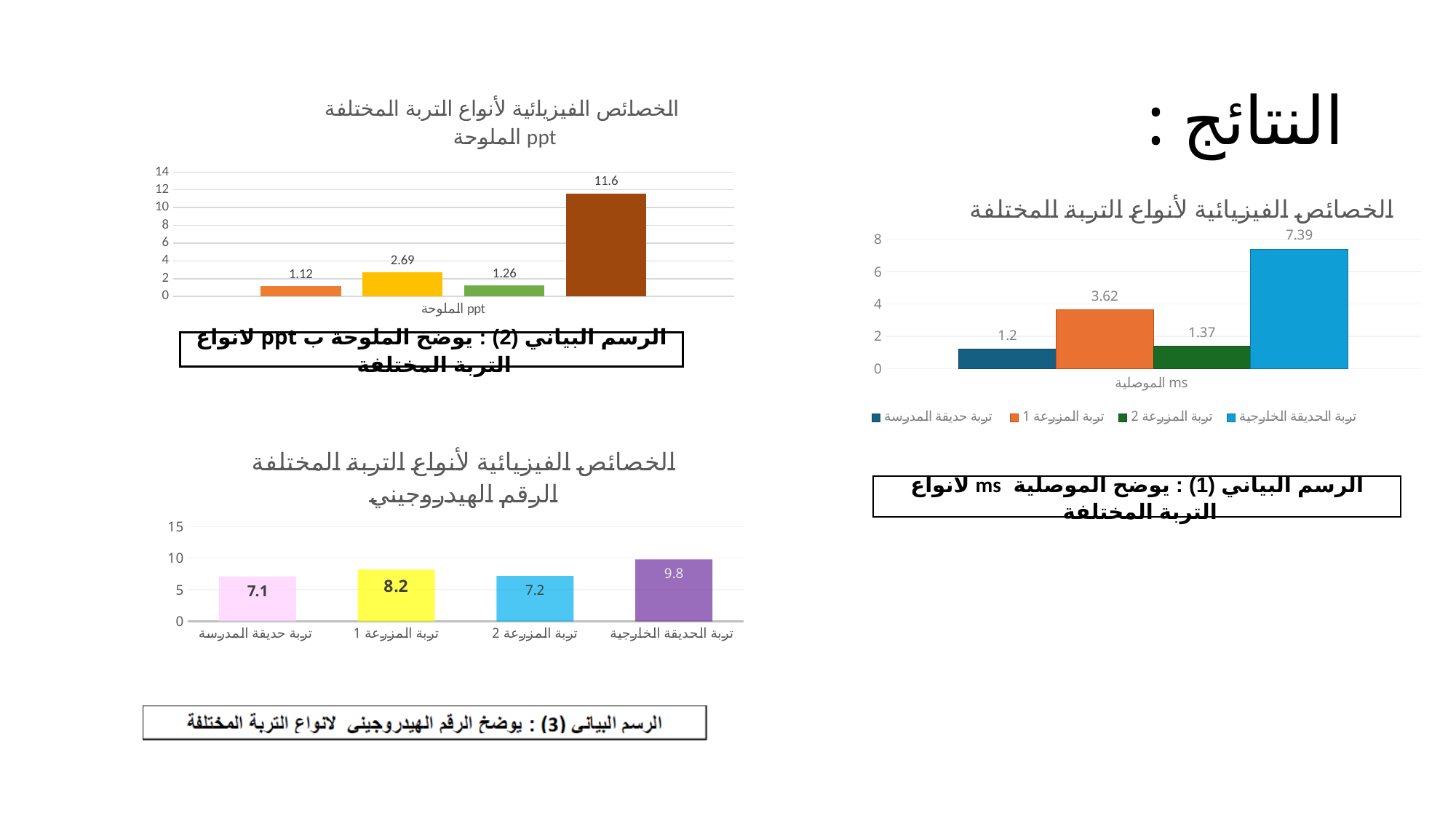
In the salinity ppt chart (الرسم البياني 2, top left), what is the highest value shown? 11.6 How many series does the legend of the conductivity chart (الرسم البياني 1, top right) list? 4 In the pH chart (الرسم البياني 3, bottom left), what is the value for تربة المزرعة 1? 8.2 In the conductivity chart (الرسم البياني 1, top right), which soil type has the lowest value? تربة حديقة المدرسة In the conductivity chart (الرسم البياني 1, top right), what is the value for تربة الحديقة الخارجية? 7.39 In the salinity ppt chart (الرسم البياني 2, top left), what is the value of the second (yellow) bar? 2.69 In the conductivity chart (الرسم البياني 1, top right), what is the difference between تربة الحديقة الخارجية and تربة المزرعة 1? 3.77 In the pH chart (الرسم البياني 3, bottom left), which soil type has the highest value? تربة الحديقة الخارجية In the salinity ppt chart (الرسم البياني 2, top left), is the value of the tallest bar greater or less than 10? greater How many bars are plotted in the salinity ppt chart (الرسم البياني 2, top left)? 4 In the conductivity chart (الرسم البياني 1, top right), what is the value for تربة المزرعة 1? 3.62 What kind of chart is the pH chart (الرسم البياني 3, bottom left)? bar chart